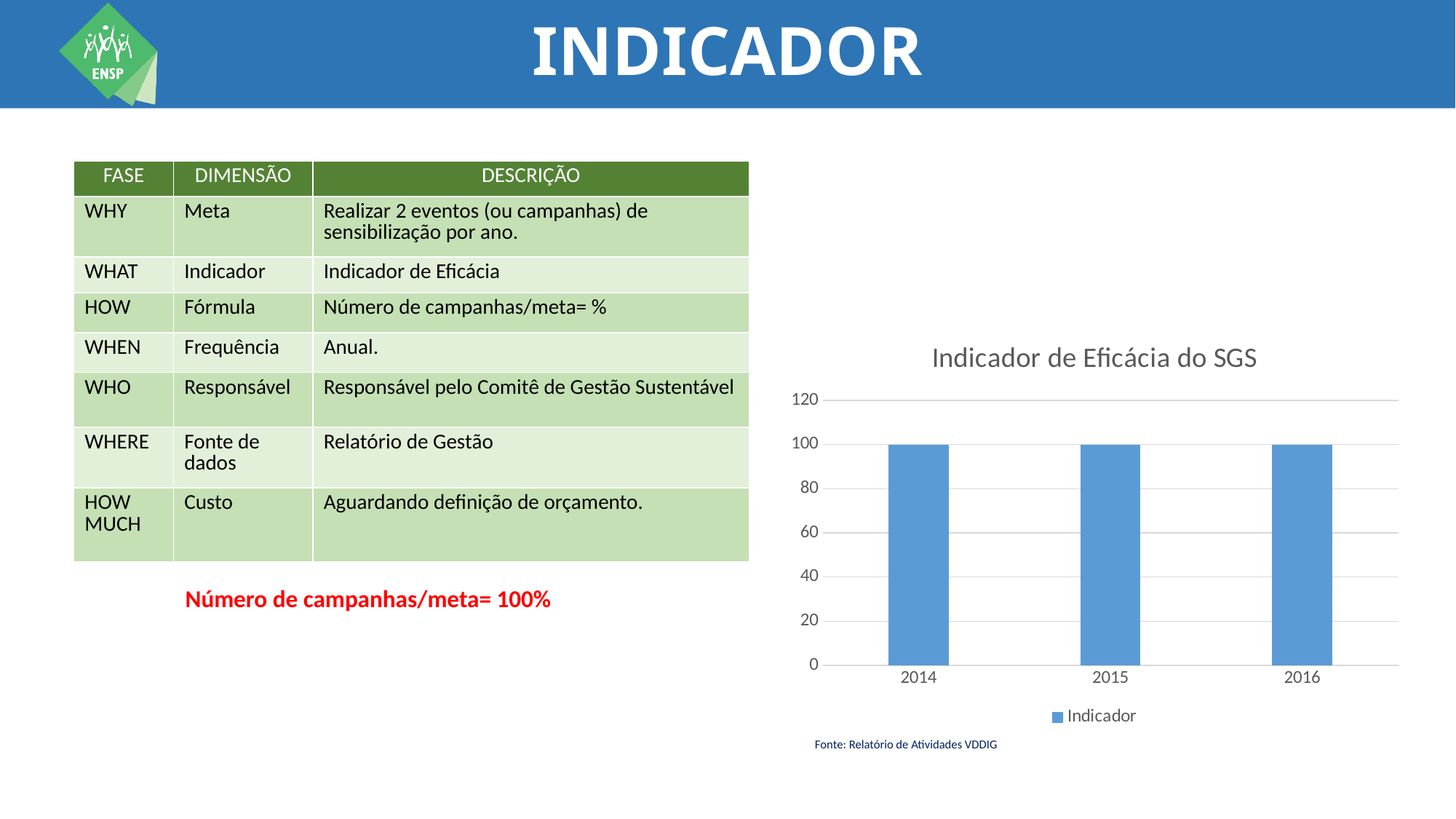
Is the value for 2015 greater or less than 80? greater What is the difference between the values for 2014 and 2016? 0 What is the value of the bar for 2015? 100 What is the title of the chart? Indicador de Eficácia do SGS What type of chart is shown on the slide? Bar chart Is the value for 2016 greater or less than 120? less How many years (categories) are shown on the x axis of the chart? 3 How many series does the chart legend list? 1 What is the value of the bar for 2014? 100 Do the values rise, fall, or stay the same from 2014 to 2016? Stay the same What is the name of the series in the chart legend? Indicador What is the value of the bar for 2016? 100